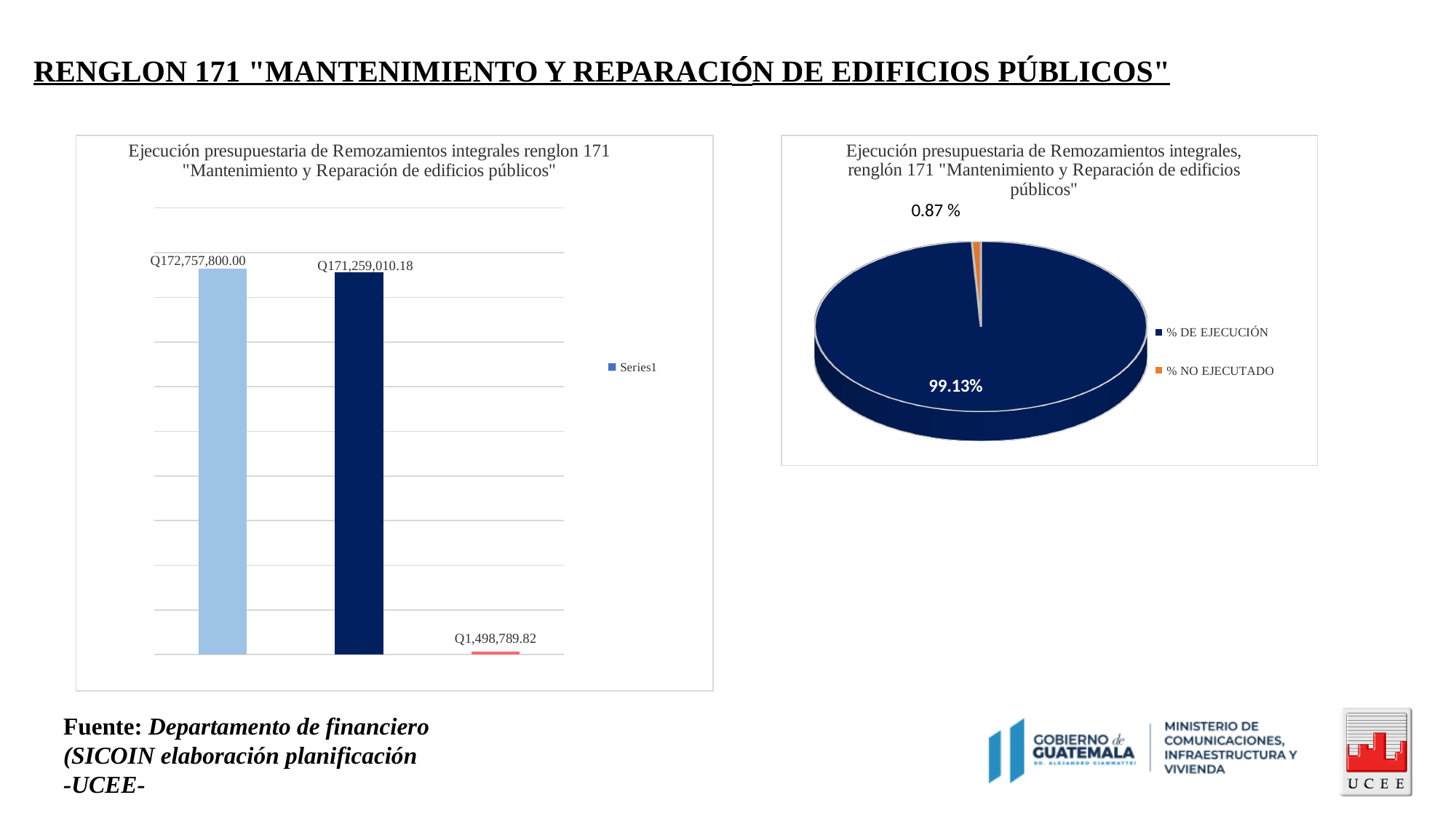
In the bar chart on the left, what is the value shown on the first (leftmost, light blue) bar? Q172,757,800.00 In the bar chart on the left, which bar has the lowest value? the third (rightmost) bar, Q1,498,789.82 In the bar chart on the left, what is the only entry listed in the legend? Series1 In the pie chart on the right, what share does the '% NO EJECUTADO' slice represent? 0.87 % In the bar chart on the left, what is the difference between the first bar (Q172,757,800.00) and the middle bar (Q171,259,010.18)? Q1,498,789.82 What type of chart is the chart on the left side of the slide? bar chart In the bar chart on the left, what is the value shown on the middle (dark blue) bar? Q171,259,010.18 In the bar chart on the left, what is the value shown on the third (rightmost, red) bar? Q1,498,789.82 What type of chart is the chart on the right side of the slide? pie chart In the bar chart on the left, which bar has the highest value? the first (leftmost) bar, Q172,757,800.00 In the pie chart on the right, what share does the '% DE EJECUCIÓN' slice represent? 99.13% How many bars are plotted in the bar chart on the left? 3